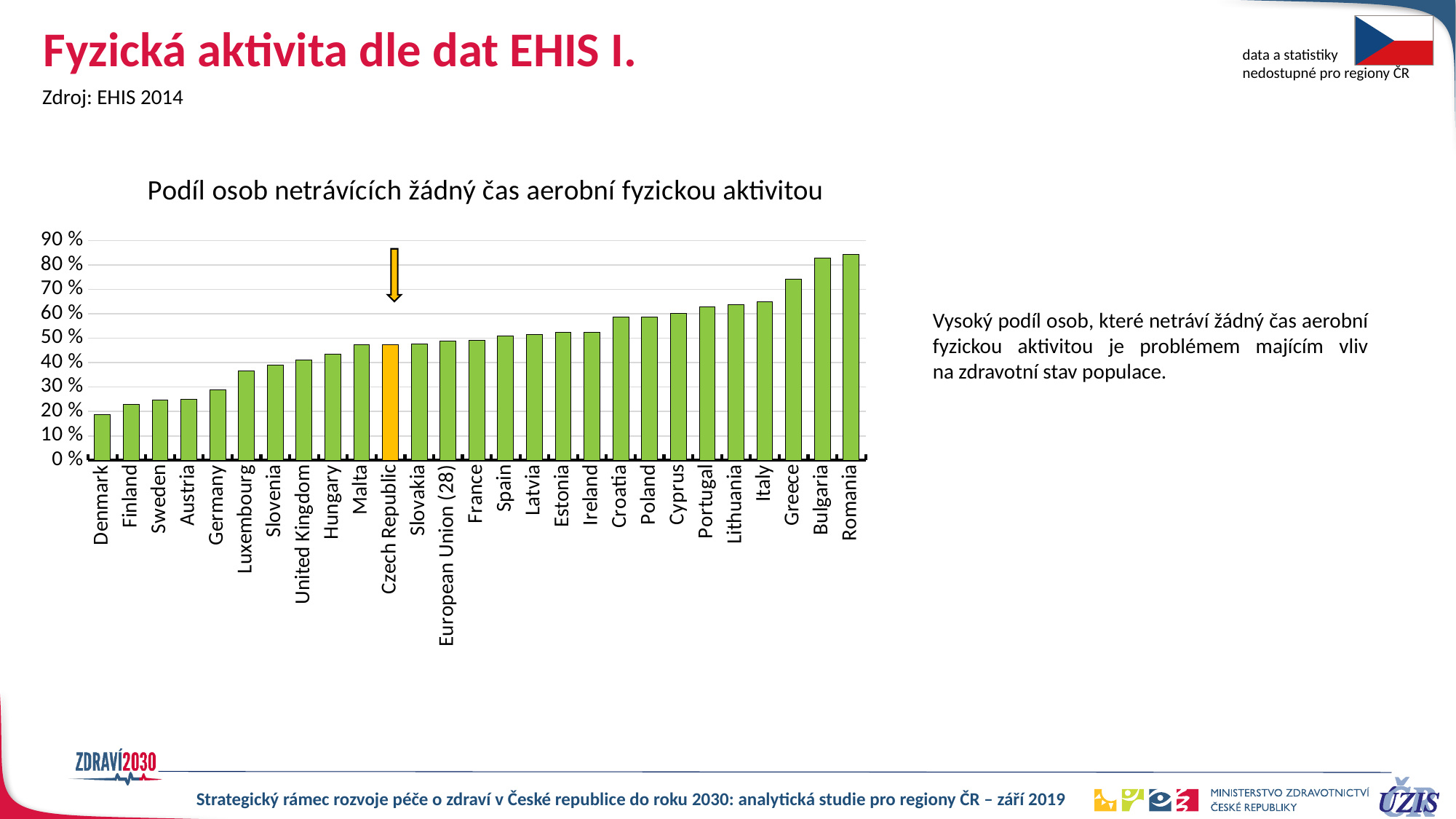
Is the value for Luxembourg greater or less than 30 %? greater Is the value for Italy greater or less than 60 %? greater How many countries/categories are plotted on the x axis of the chart? 27 Which has the larger value, Greece or Italy? Greece Is the value for Romania greater or less than 80 %? greater Do the values rise or fall from left to right along the x axis? rise What kind of chart is shown on the slide? bar chart Which country's bar is highlighted in orange with an arrow above it? Czech Republic Which category has the lowest value in the chart? Denmark Which has the larger value, Poland or Sweden? Poland